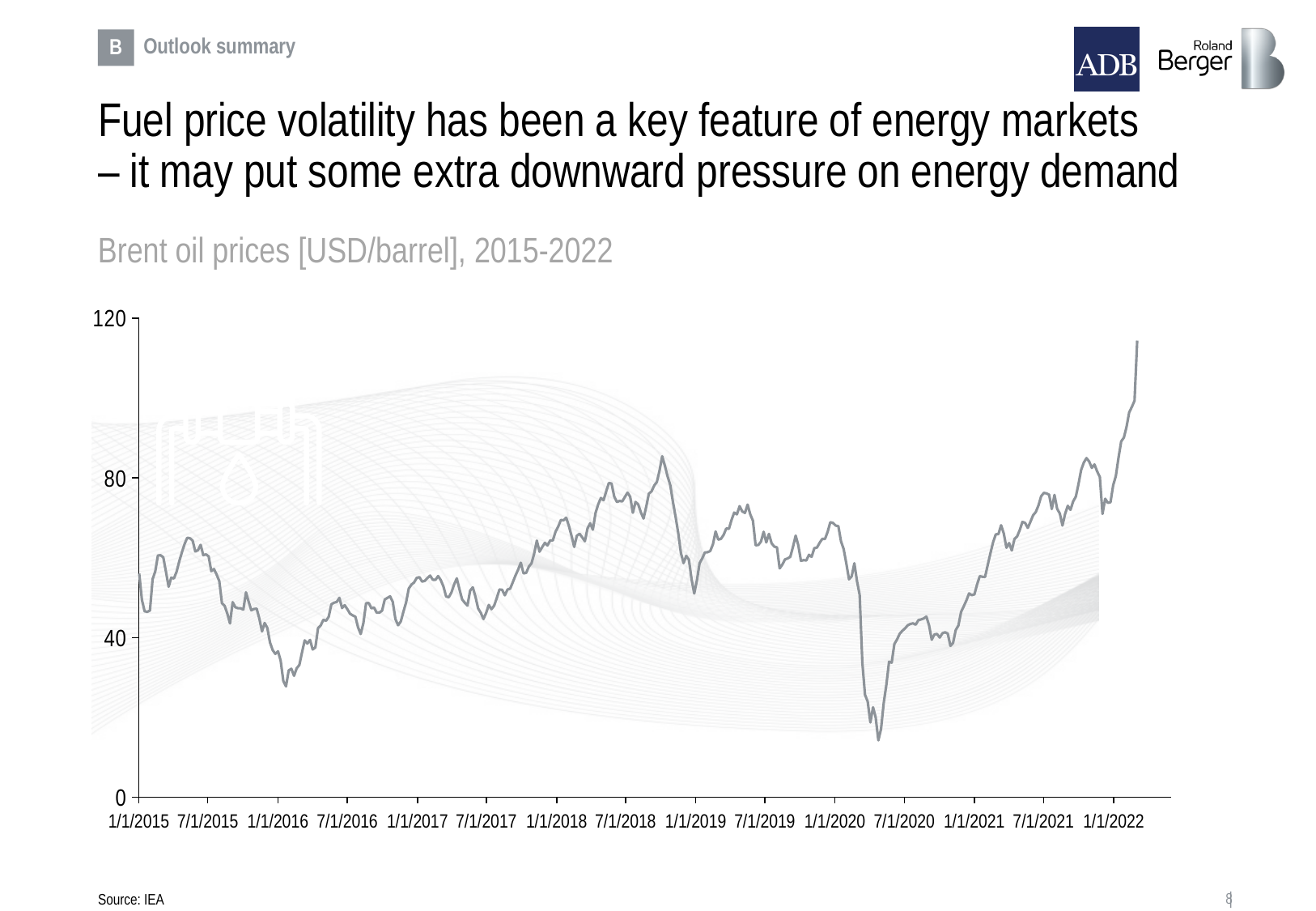
Is the Brent oil price at 7/1/2018 greater or less than 40? greater Is the Brent oil price at the end of the series in early 2022 greater or less than 80? greater What is the highest value shown on the y axis? 120 Does the Brent oil price rise or fall between 1/1/2021 and 1/1/2022? rise In which year does the Brent oil price reach its lowest point on the chart? 2020 In which year does the Brent oil price reach its highest point on the chart? 2022 Is the Brent oil price at 1/1/2016 greater or less than 40? less What is the title of the chart? Brent oil prices [USD/barrel], 2015-2022 Does the Brent oil price rise or fall between 1/1/2020 and 7/1/2020? fall What kind of chart is shown on the slide? Line chart